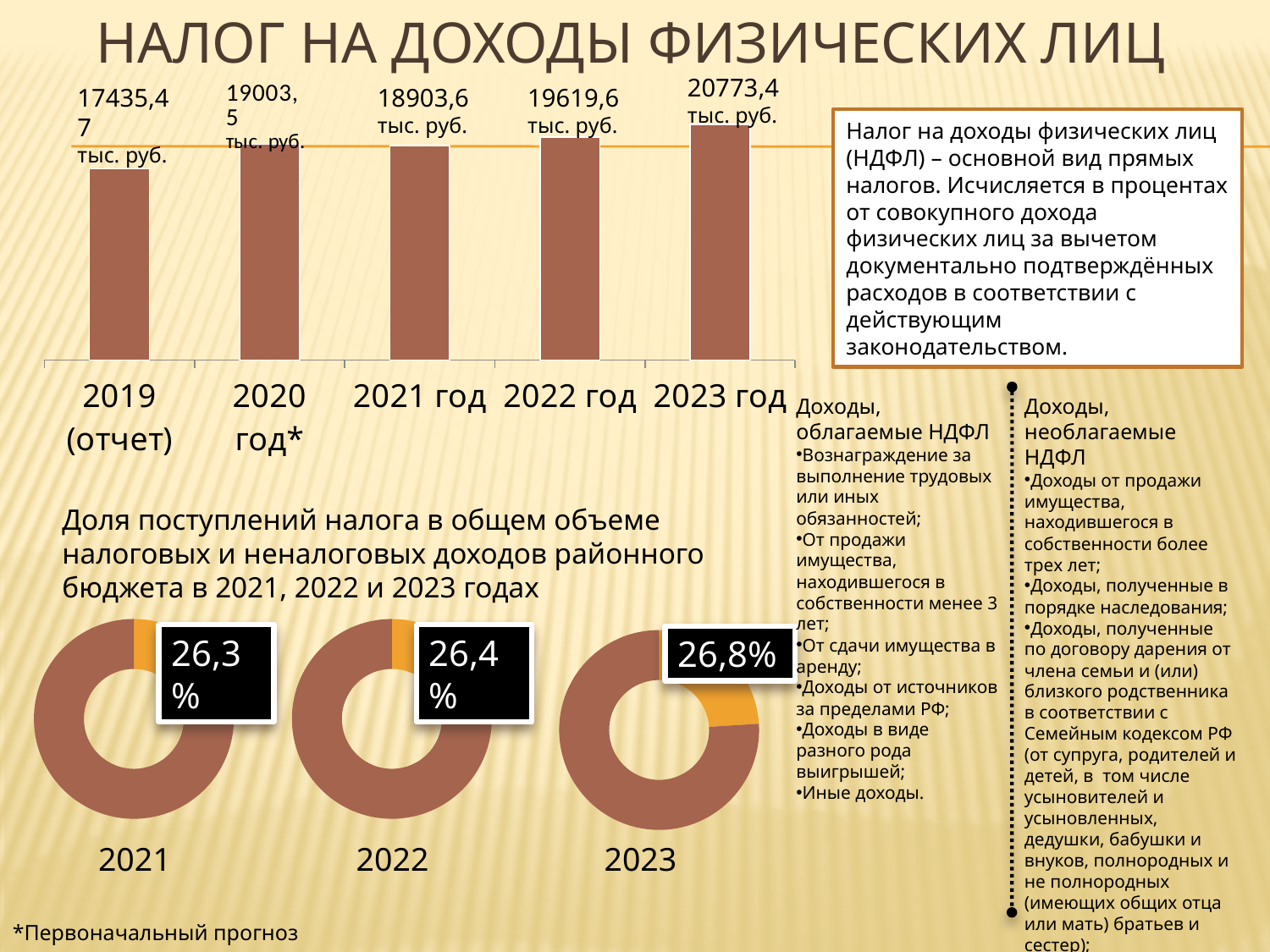
What kind of chart is shown at the top left of the slide? Bar chart In the bar chart at the top left, what is the difference between the 2022 год and 2021 год values? 716 тыс. руб. In the bar chart at the top left, which is larger: the value for 2020 год* or for 2021 год? 2020 год* In the donut charts at the bottom left, what share is shown for 2023? 26,8% In the bar chart at the top left, what is the value for 2023 год? 20773,4 тыс. руб. How many bars does the bar chart at the top left have? 5 In the donut charts at the bottom left, which year has the highest share: 2021, 2022 or 2023? 2023 In the bar chart at the top left, what is the value for 2020 год*? 19003,5 тыс. руб. In the bar chart at the top left, what is the value for 2022 год? 19619,6 тыс. руб. In the bar chart at the top left, which year has the lowest value? 2019 (отчет) In the bar chart at the top left, what is the difference between the 2023 год and 2022 год values? 1153,8 тыс. руб. In the bar chart at the top left, which year has the highest value? 2023 год